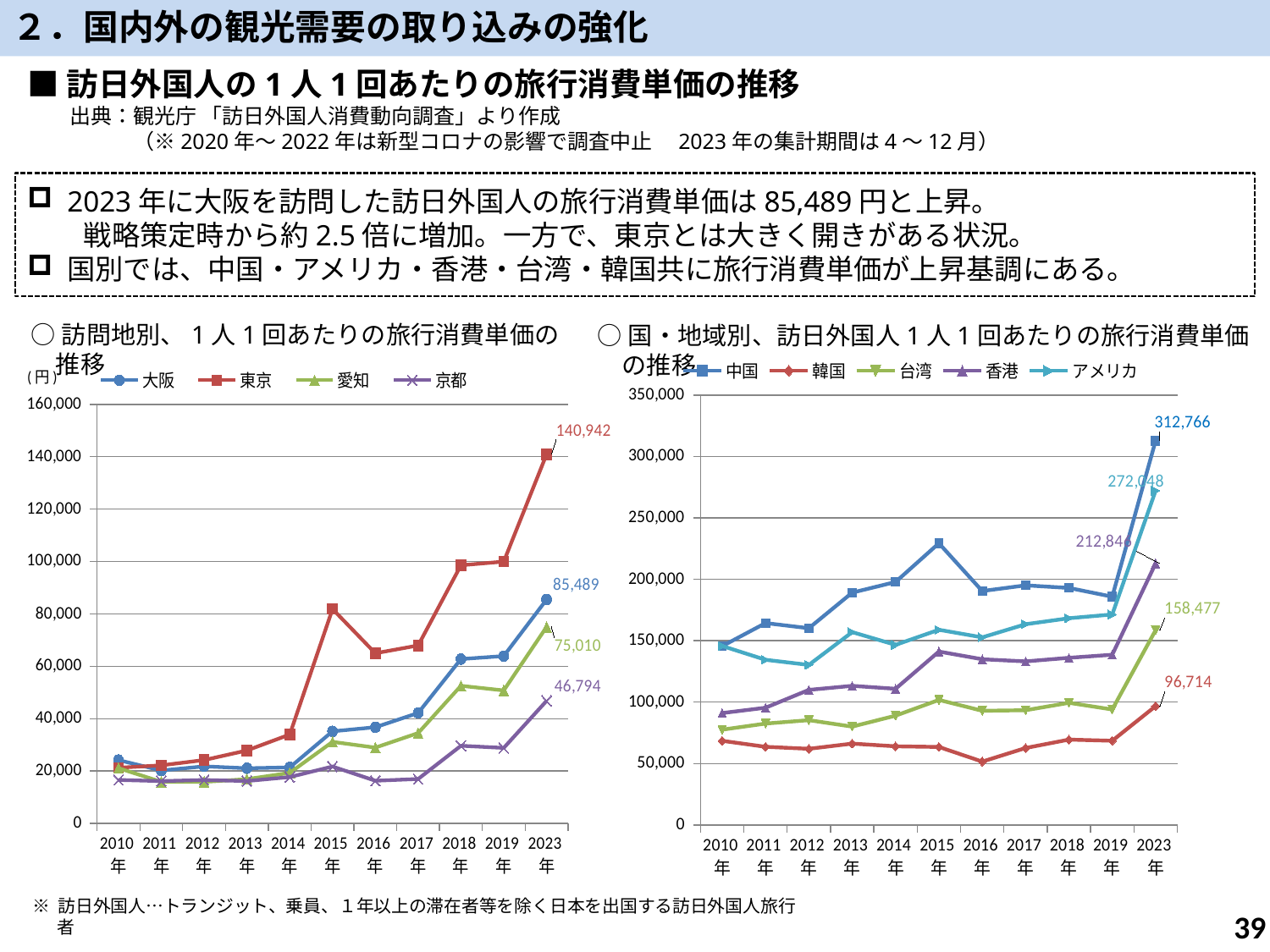
In the left chart (訪問地別), which series has the highest value in 2023年? 東京 What kind of chart is the right chart (国・地域別)? line chart In the left chart (訪問地別), what is the value for 京都 in 2023年? 46,794 In the left chart (訪問地別), how many series does the legend list? 4 In the right chart (国・地域別), which series has the lowest value in 2023年? 韓国 In the right chart (国・地域別), what is the value for 韓国 in 2023年? 96,714 In the left chart (訪問地別), what is the value for 大阪 in 2023年? 85,489 In the right chart (国・地域別), what is the value for 中国 in 2023年? 312,766 In the left chart (訪問地別), is the value for 東京 in 2015年 greater or less than 60,000? greater In the right chart (国・地域別), how many years are plotted on the x axis? 11 In the left chart (訪問地別), what is the value for 東京 in 2023年? 140,942 In the left chart (訪問地別), what is the difference between 東京 and 大阪 in 2023年? 55,453